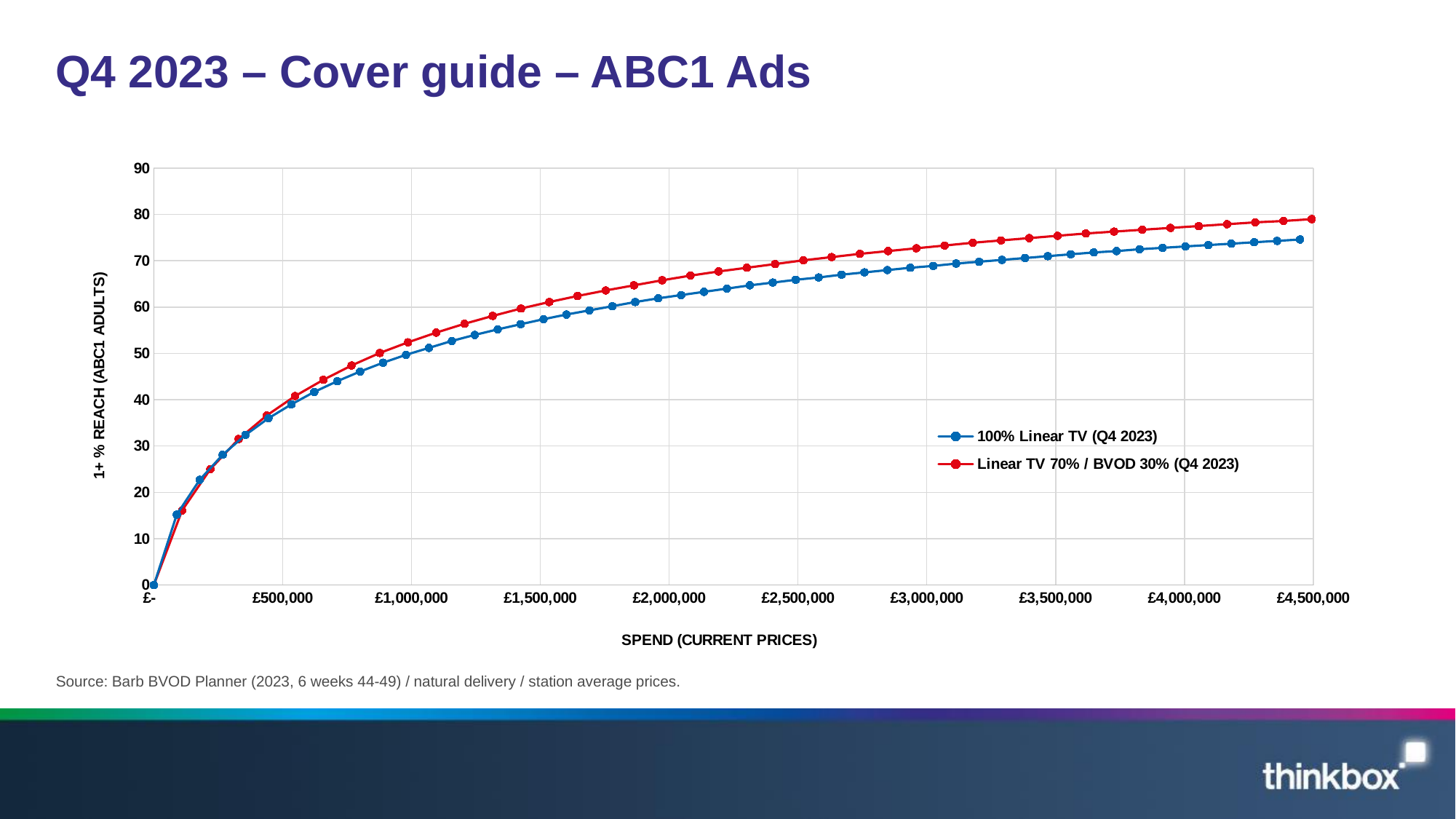
Is the 1+ % reach for Linear TV 70% / BVOD 30% (Q4 2023) at a spend of £2,000,000 greater or less than 60? greater Is the 1+ % reach for 100% Linear TV (Q4 2023) at a spend of £3,000,000 greater or less than 70? less Do the values for 100% Linear TV (Q4 2023) rise or fall as spend increases along the x axis? Rise Is the 1+ % reach for 100% Linear TV (Q4 2023) at a spend of £4,500,000 greater or less than 70? greater What is the title of the x axis? SPEND (CURRENT PRICES) Which series is plotted in red? Linear TV 70% / BVOD 30% (Q4 2023) At a spend of £2,000,000, which series has the higher 1+ % reach: 100% Linear TV (Q4 2023) or Linear TV 70% / BVOD 30% (Q4 2023)? Linear TV 70% / BVOD 30% (Q4 2023) How many series does the legend list? 2 What kind of chart is shown on the slide? Line chart At a spend of £4,500,000, which series has the higher 1+ % reach: 100% Linear TV (Q4 2023) or Linear TV 70% / BVOD 30% (Q4 2023)? Linear TV 70% / BVOD 30% (Q4 2023)